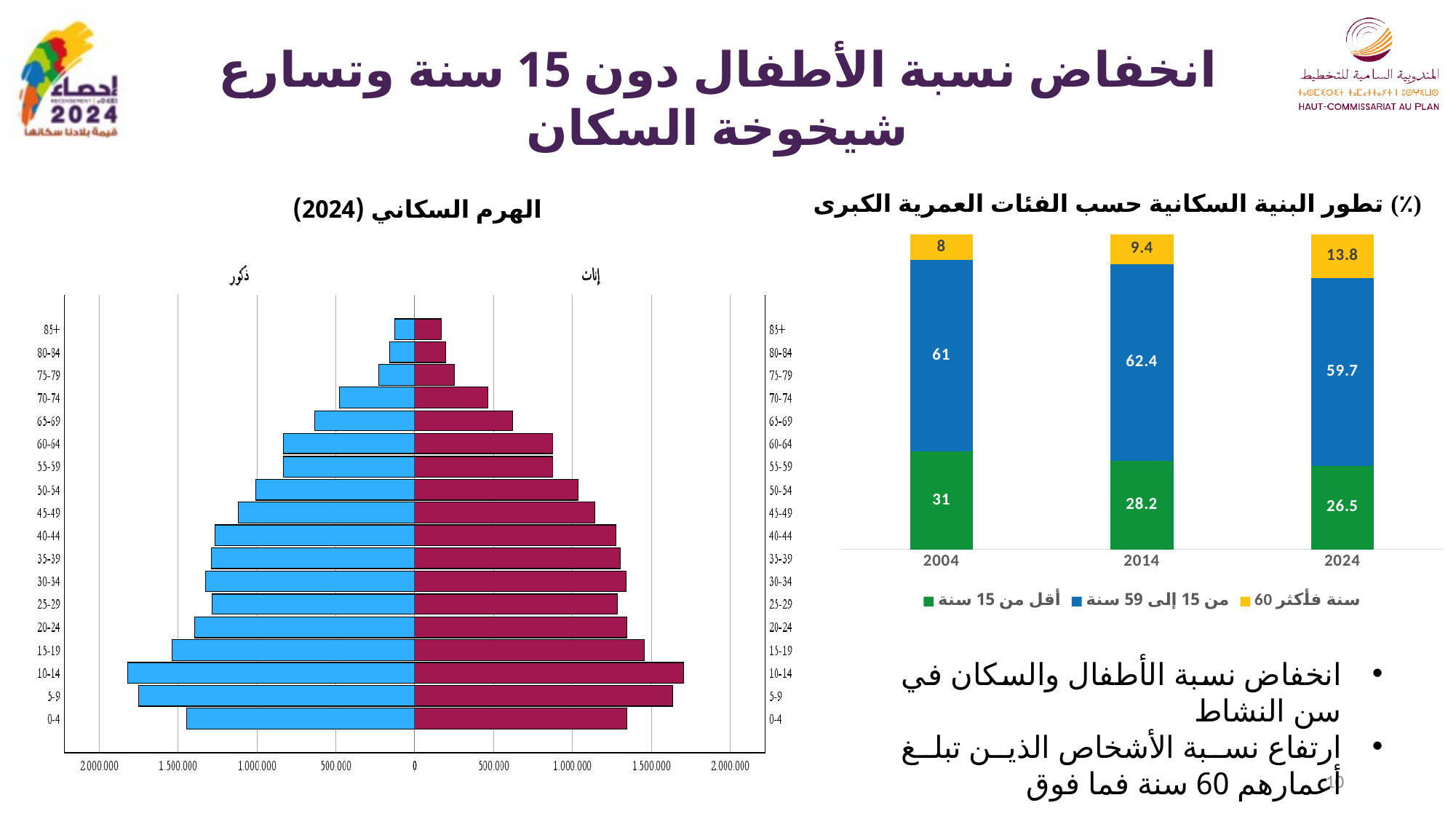
In the stacked bar chart on the right, which year has the highest value for the 60 and over age group? 2024 In the stacked bar chart on the right, what is the value for the under-15 age group (أقل من 15 سنة) in 2024? 26.5 In the population pyramid on the left, is the value for males aged 10-14 greater or less than 1.500.000? greater In the stacked bar chart on the right, how many years are shown on the x axis? 3 In the stacked bar chart on the right, what is the difference between the under-15 values for 2004 and 2024? 4.5 In the stacked bar chart on the right, does the under-15 share rise or fall from 2004 to 2024? fall In the stacked bar chart on the right, what is the value for the 15 to 59 age group (من 15 إلى 59 سنة) in 2014? 62.4 In the population pyramid on the left, how many age groups are shown? 18 In the stacked bar chart on the right, what is the value for the 60 and over age group (60 سنة فأكثر) in 2004? 8 In the stacked bar chart on the right, how many series does the legend list? 3 In the stacked bar chart on the right, which year has the lowest value for the under-15 age group? 2024 In the population pyramid on the left, which age group has the longest bar for males (ذكور)? 10-14